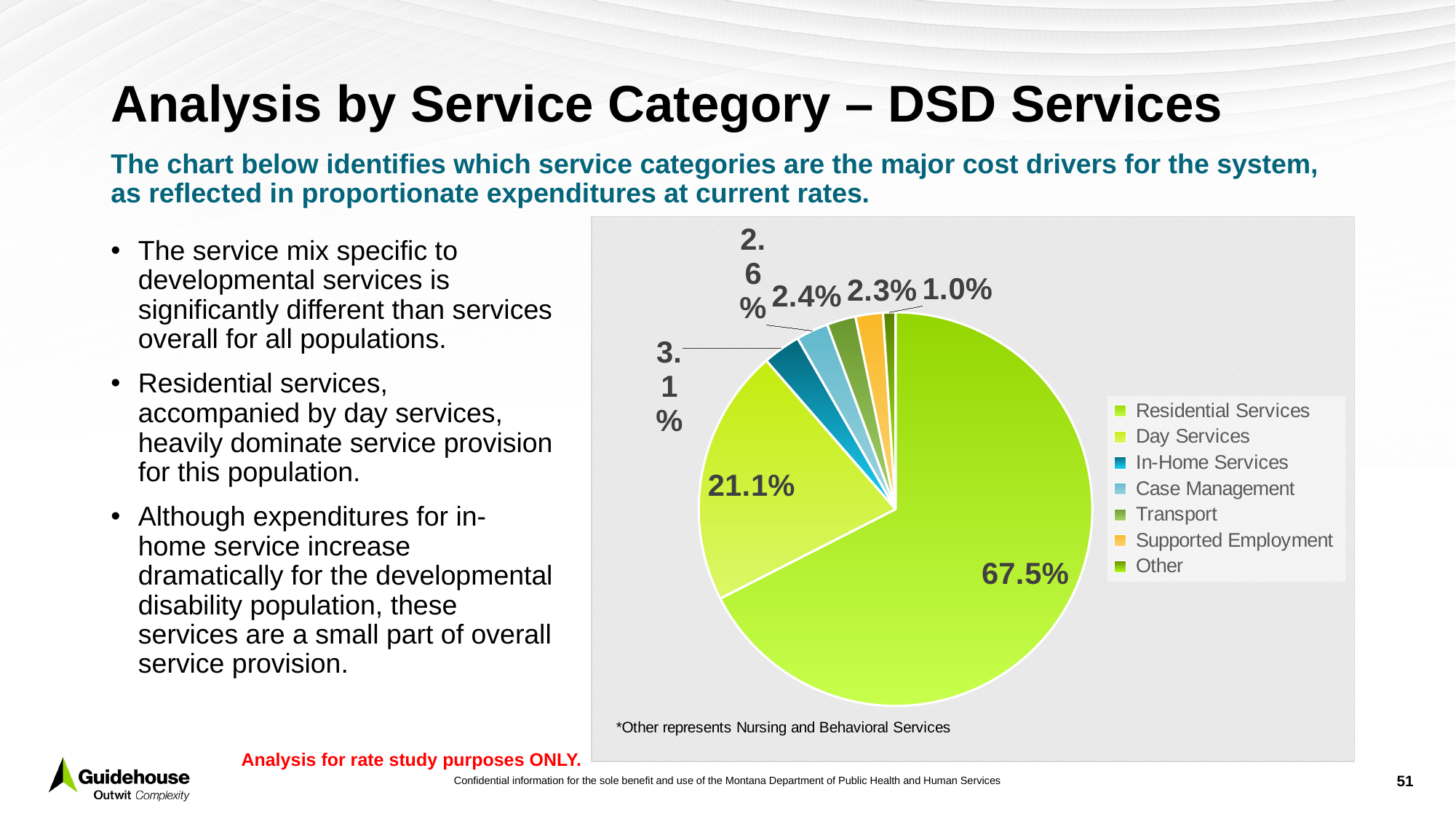
What is the combined share of Residential Services and Day Services? 88.6% Which is larger, the share for Day Services or the share for In-Home Services? Day Services What share of expenditures does Day Services account for? 21.1% What share of expenditures does Residential Services account for? 67.5% Which service category has the smallest slice of the pie? Other What share of expenditures does In-Home Services account for? 3.1% What share of expenditures does Other account for? 1.0% Which service category has the largest slice of the pie? Residential Services How many service categories does the legend list? 7 According to the footnote, what does the Other category represent? Nursing and Behavioral Services What type of chart is shown on the slide? pie chart What is the difference in percentage points between Residential Services and Day Services? 46.4